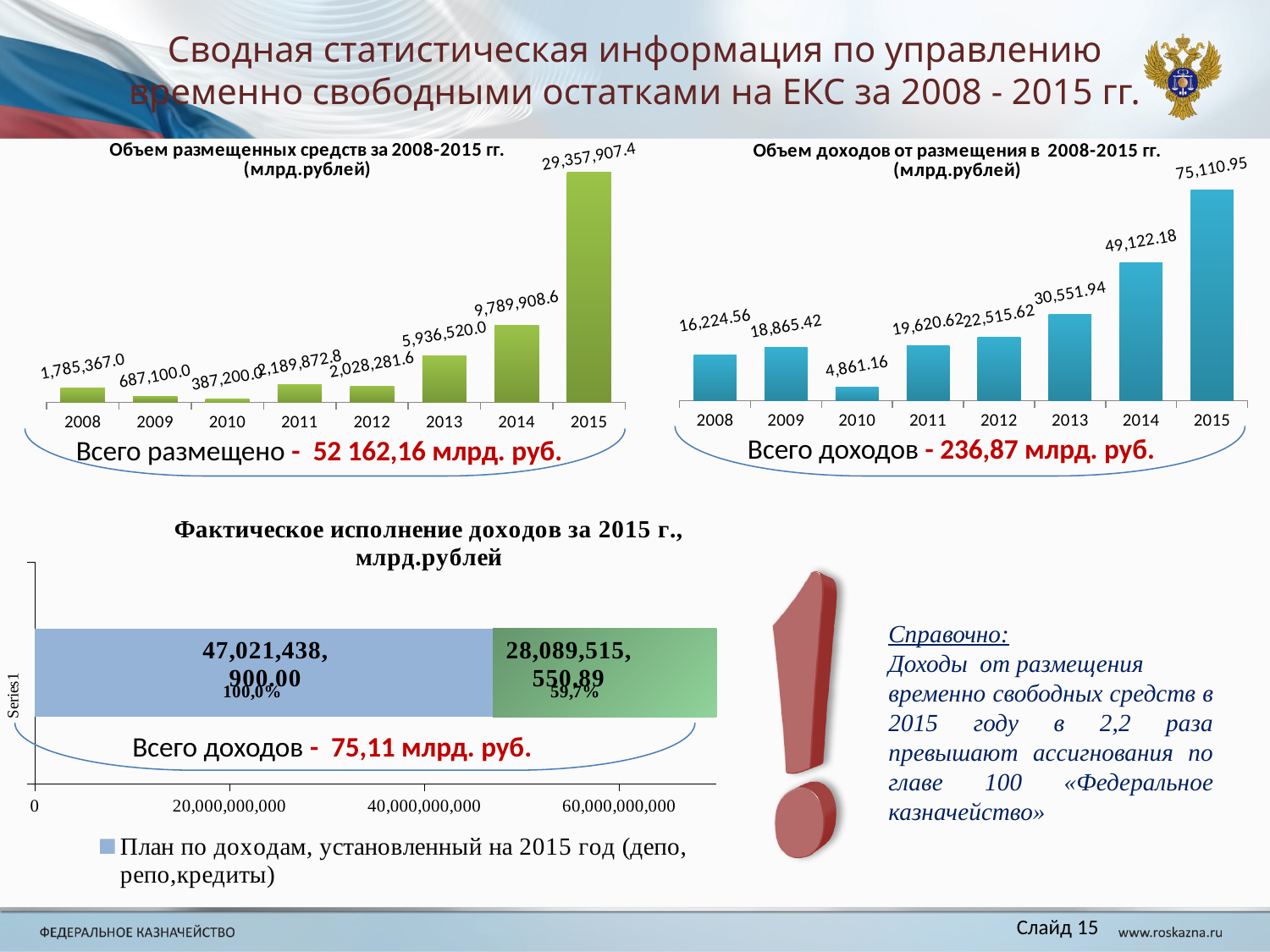
In the chart 'Объем размещенных средств за 2008-2015 гг.', what is the value for 2013? 5,936,520.0 In the chart 'Объем размещенных средств за 2008-2015 гг.', which year has the lowest value? 2010 In the chart 'Объем доходов от размещения в 2008-2015 гг.', which year has the highest value? 2015 In the chart 'Фактическое исполнение доходов за 2015 г., млрд.рублей', what is the value of the blue segment? 47,021,438,900.00 What kind of chart is 'Фактическое исполнение доходов за 2015 г., млрд.рублей'? bar chart In the chart 'Объем доходов от размещения в 2008-2015 гг.', what is the difference between the values for 2015 and 2014? 25,988.77 In the chart 'Объем доходов от размещения в 2008-2015 гг.', which is larger: the value for 2009 or the value for 2011? 2011 In the chart 'Объем доходов от размещения в 2008-2015 гг.', what is the value for 2014? 49,122.18 In the chart 'Фактическое исполнение доходов за 2015 г., млрд.рублей', what is the value of the green segment? 28,089,515,550.89 In the chart 'Объем размещенных средств за 2008-2015 гг.', what is the value for 2015? 29,357,907.4 In the chart 'Объем размещенных средств за 2008-2015 гг.', how many years are shown on the x axis? 8 In the chart 'Объем доходов от размещения в 2008-2015 гг.', which year has the lowest value? 2010